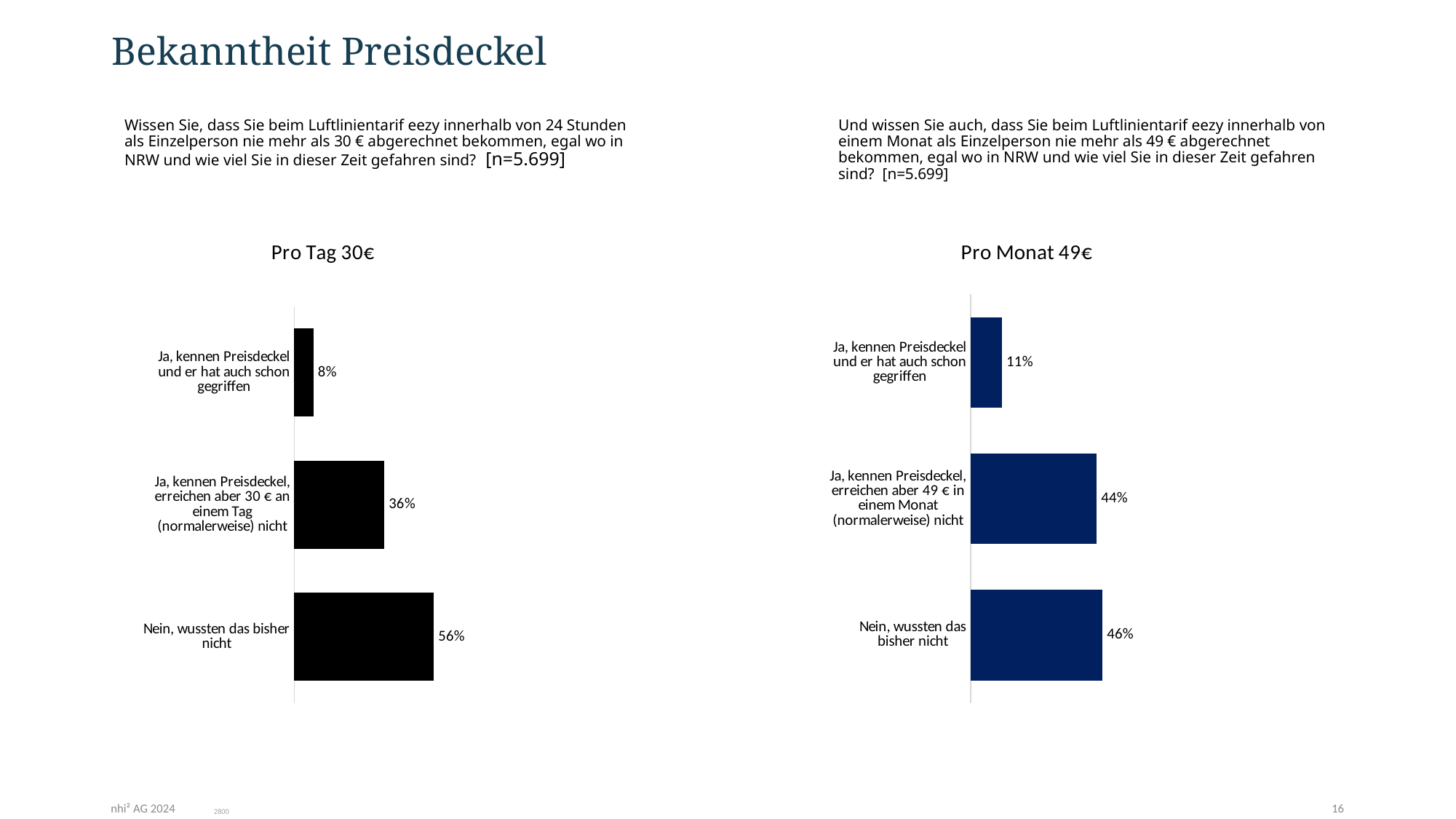
Which is larger: the 'Nein, wussten das bisher nicht' value in the 'Pro Tag 30€' chart or in the 'Pro Monat 49€' chart? Pro Tag 30€ In the 'Pro Monat 49€' chart, which category has the highest value? Nein, wussten das bisher nicht In the 'Pro Monat 49€' chart, what is the value for 'Ja, kennen Preisdeckel und er hat auch schon gegriffen'? 11% In the 'Pro Tag 30€' chart, what is the value for 'Ja, kennen Preisdeckel, erreichen aber 30 € an einem Tag (normalerweise) nicht'? 36% What is the title of the chart on the left side of the slide? Pro Tag 30€ How many categories does the 'Pro Tag 30€' chart show? 3 What kind of chart is the 'Pro Monat 49€' chart? Bar chart In the 'Pro Tag 30€' chart, what is the value for 'Nein, wussten das bisher nicht'? 56% What colour are the bars in the 'Pro Monat 49€' chart? Dark blue In the 'Pro Tag 30€' chart, what is the difference between 'Nein, wussten das bisher nicht' and 'Ja, kennen Preisdeckel und er hat auch schon gegriffen'? 48% In the 'Pro Monat 49€' chart, what is the difference between 'Nein, wussten das bisher nicht' and 'Ja, kennen Preisdeckel, erreichen aber 49 € in einem Monat (normalerweise) nicht'? 2% In the 'Pro Tag 30€' chart, which category has the lowest value? Ja, kennen Preisdeckel und er hat auch schon gegriffen